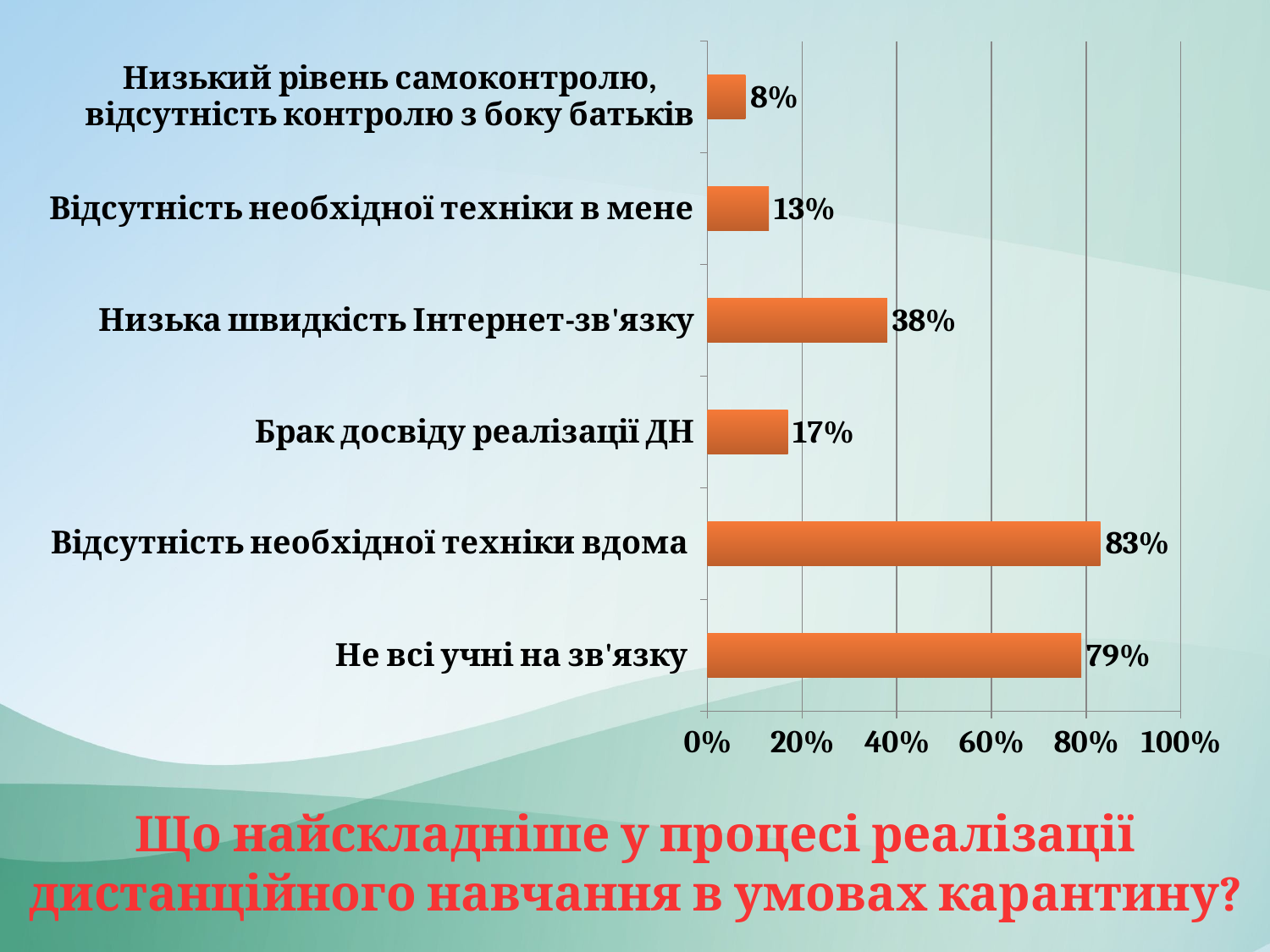
What kind of chart is shown on the slide? bar chart What is the value for "Низька швидкість Інтернет-зв'язку"? 38% Which category has the highest value? Відсутність необхідної техніки вдома What is the value for "Брак досвіду реалізації ДН"? 17% Which is larger: the value for "Відсутність необхідної техніки в мене" or for "Брак досвіду реалізації ДН"? Брак досвіду реалізації ДН What is the value for "Відсутність необхідної техніки вдома"? 83% Which category has the lowest value? Низький рівень самоконтролю, відсутність контролю з боку батьків What is the difference between the values for "Відсутність необхідної техніки вдома" and "Не всі учні на зв'язку"? 4% How many categories are shown in the chart? 6 What is the title text shown below the chart? Що найскладніше у процесі реалізації дистанційного навчання в умовах карантину? What is the value for "Не всі учні на зв'язку"? 79% Is the value for "Низька швидкість Інтернет-зв'язку" greater or less than 40%? less